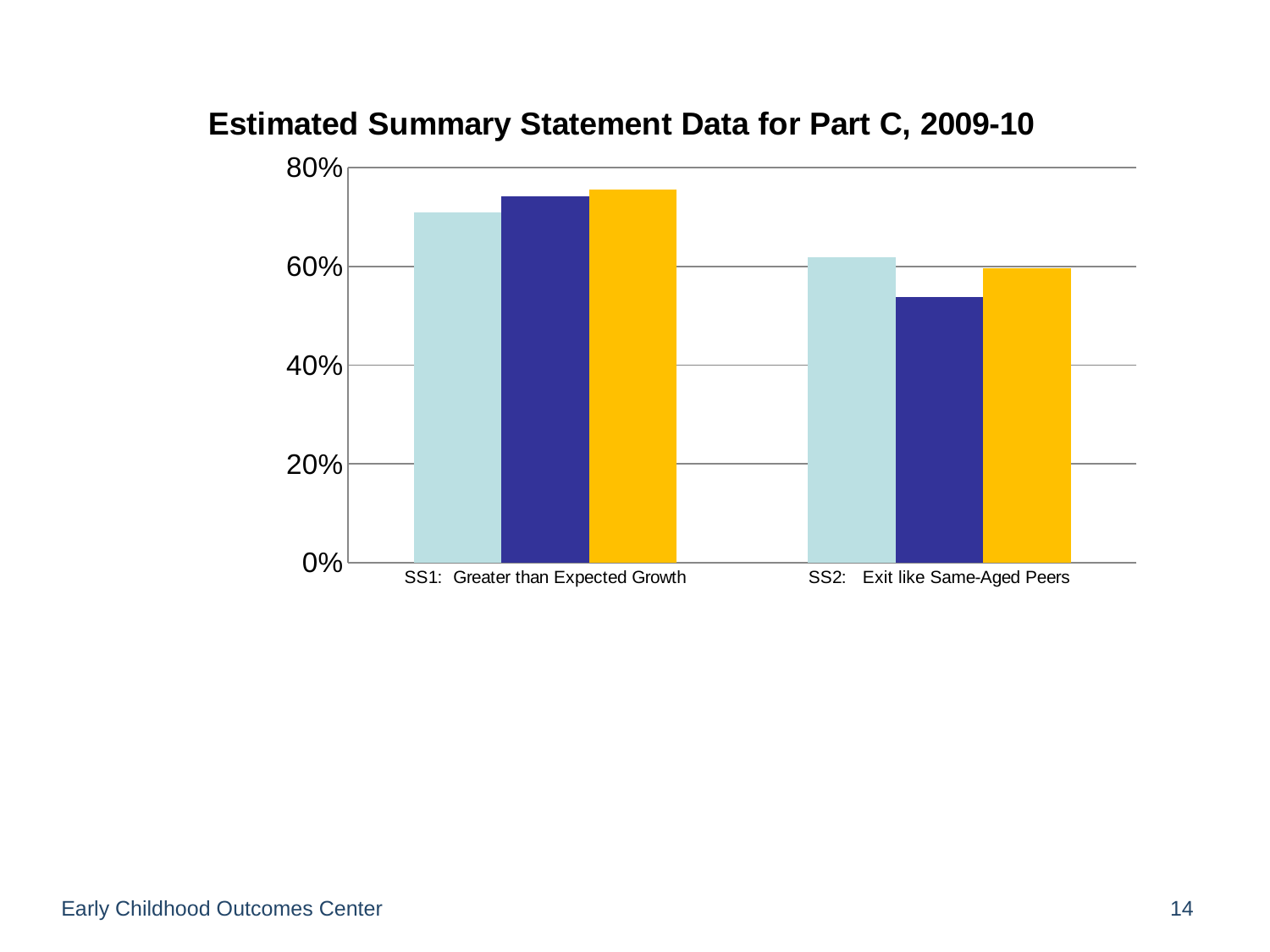
How many categories are shown on the x axis? 2 Which category has the higher light blue bar, SS1: Greater than Expected Growth or SS2: Exit like Same-Aged Peers? SS1: Greater than Expected Growth How many bars are plotted for each category? 3 Within SS1: Greater than Expected Growth, which coloured bar is the lowest? light blue Is the value of the yellow bar for SS1: Greater than Expected Growth greater or less than 80%? less What is the title of the chart? Estimated Summary Statement Data for Part C, 2009-10 Is the value of the dark blue bar for SS2: Exit like Same-Aged Peers greater or less than 60%? less What kind of chart is shown on the slide? bar chart Do the values rise or fall from SS1: Greater than Expected Growth to SS2: Exit like Same-Aged Peers? fall Is the value of the dark blue bar for SS2: Exit like Same-Aged Peers greater or less than 40%? greater Within SS2: Exit like Same-Aged Peers, which coloured bar is the lowest? dark blue